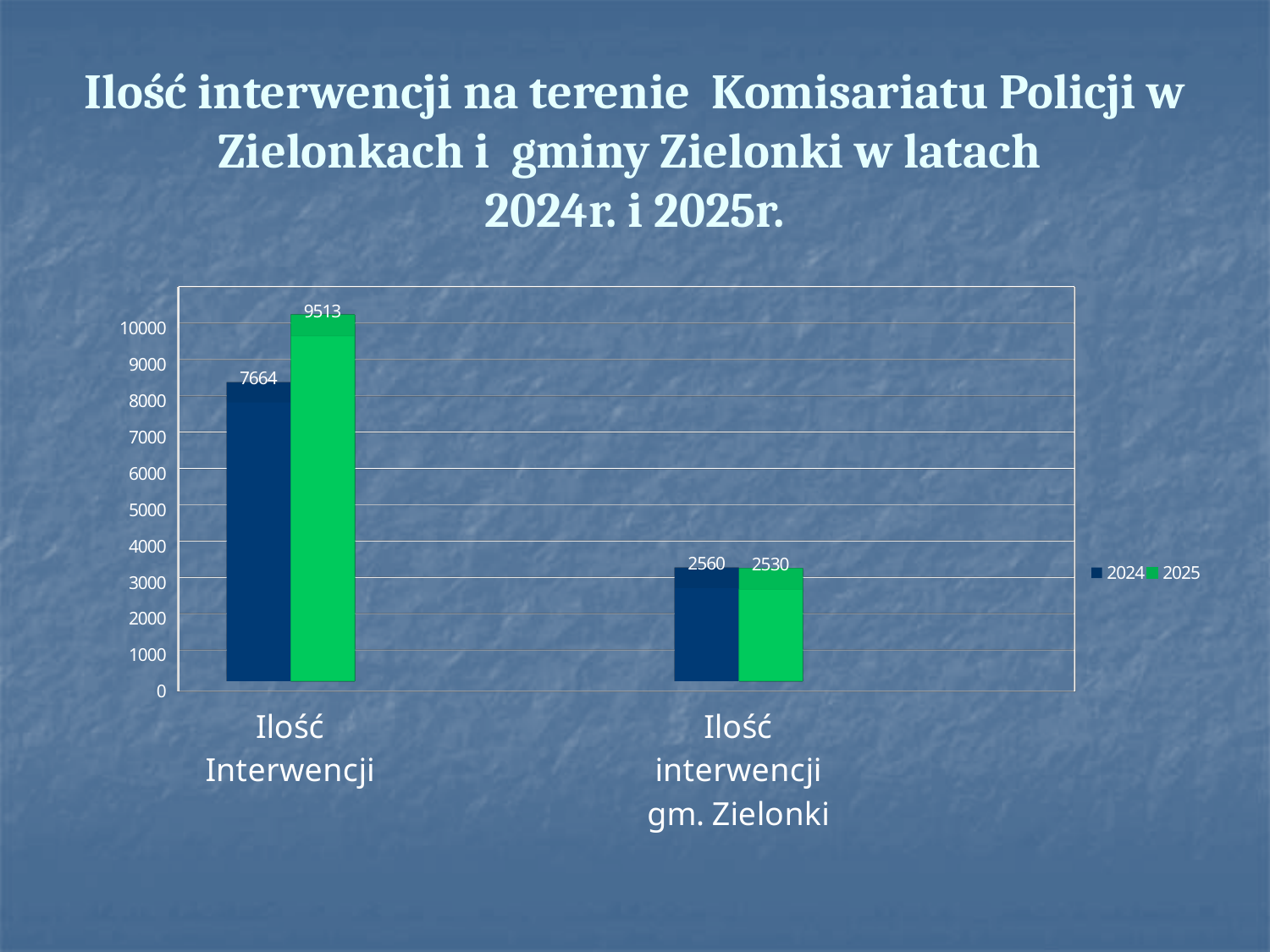
How many series does the legend list? 2 What is the difference between the 2024 and 2025 values in the 'Ilość interwencji gm. Zielonki' category? 30 How many categories are shown on the x axis? 2 What is the difference between the 2025 and 2024 values in the 'Ilość Interwencji' category? 1849 What is the value for 2025 in the 'Ilość interwencji gm. Zielonki' category? 2530 What kind of chart is shown on the slide? Bar chart Which series has the higher value in the 'Ilość Interwencji' category, 2024 or 2025? 2025 Which bar on the chart has the highest value? 2025 in Ilość Interwencji What is the value for 2024 in the 'Ilość interwencji gm. Zielonki' category? 2560 What is the value for 2024 in the 'Ilość Interwencji' category? 7664 What is the value for 2025 in the 'Ilość Interwencji' category? 9513 Which colour represents the 2025 series in the legend? Green